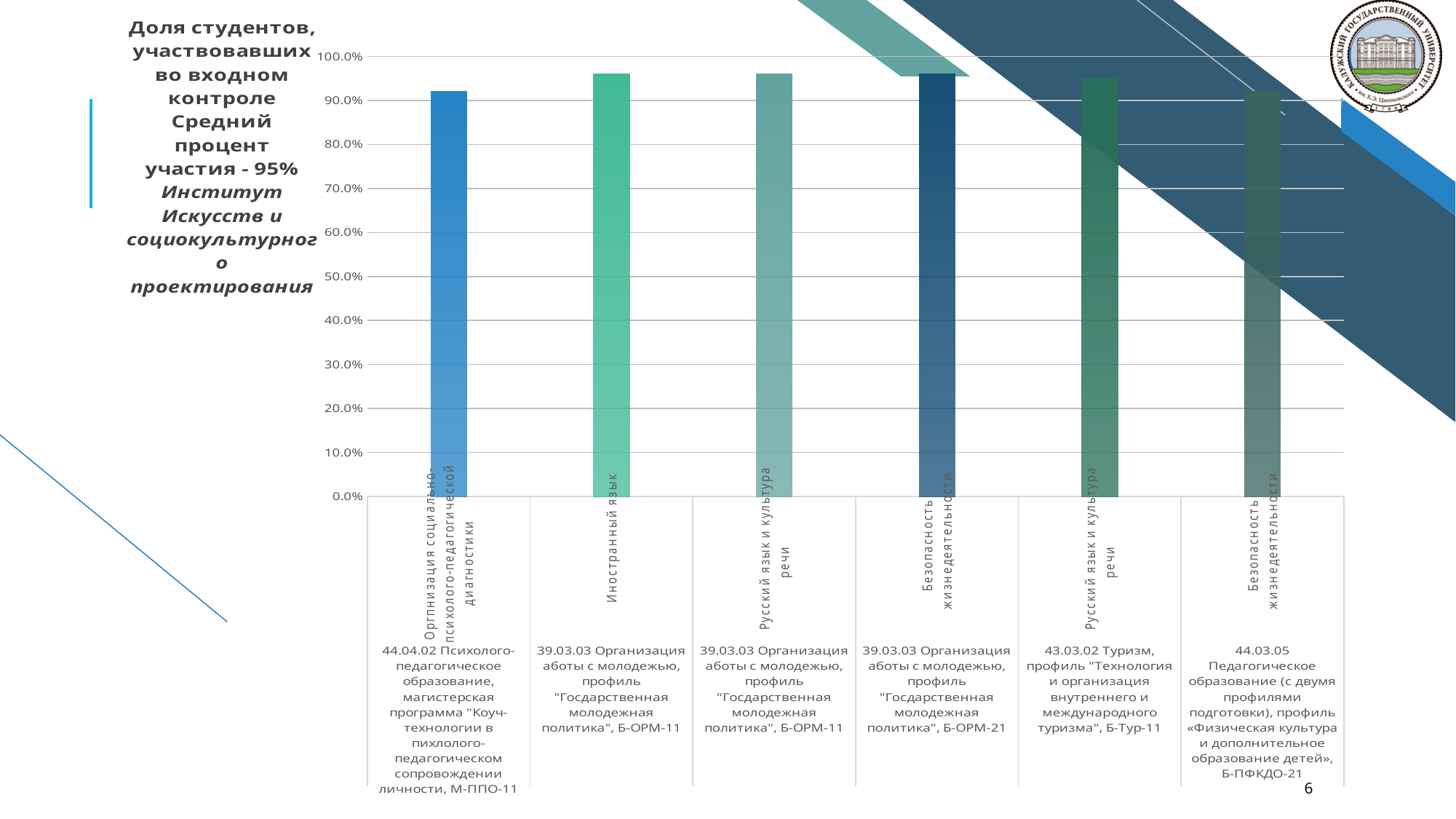
What kind of chart is shown on the slide? bar chart Is the value for Русский язык и культура речи (43.03.02 Туризм, Б-Тур-11) greater or less than 90.0%? greater What is the highest tick value shown on the vertical axis? 100.0% Is the value for Организация социально-психолого-педагогической диагностики (44.04.02, М-ППО-11) greater or less than 80.0%? greater Is the value for Безопасность жизнедеятельности (44.03.05, Б-ПФКДО-21) greater or less than 80.0%? greater How many bars (programs) are plotted in the chart? 6 What is the average participation percentage stated in the chart title text? 95% Which is larger: the value for Иностранный язык (Б-ОРМ-11) or the value for Организация социально-психолого-педагогической диагностики (М-ППО-11)? Иностранный язык (Б-ОРМ-11)